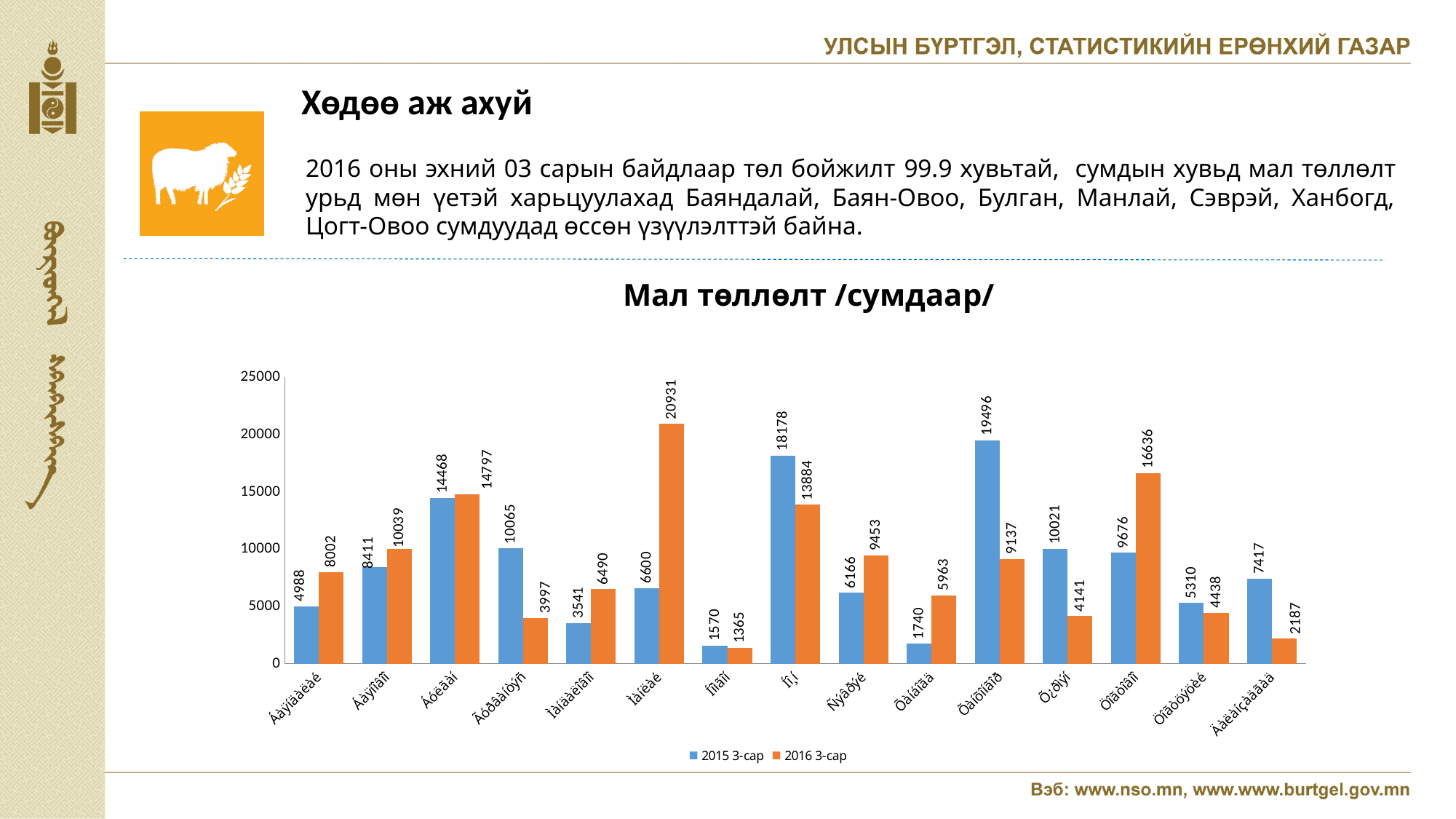
What is the value of the 2015 3-сар series for the sixth category from the left? 6600 Which series is shown in orange in the chart? 2016 3-сар What is the lowest value shown for the 2016 3-сар series? 1365 What is the difference between the 2016 3-сар and 2015 3-сар values for the sixth category from the left? 14331 What is the highest value shown for the 2016 3-сар series? 20931 What is the highest value shown for the 2015 3-сар series? 19496 What is the title of the chart on the slide? Мал төллөлт /сумдаар/ How many categories are plotted along the x axis of the chart? 15 What is the value of the 2016 3-сар series for the first category from the left? 8002 What kind of chart is shown on the slide? bar chart For the eighth category from the left, which series has the larger value, 2015 3-сар or 2016 3-сар? 2015 3-сар How many series does the chart legend list? 2